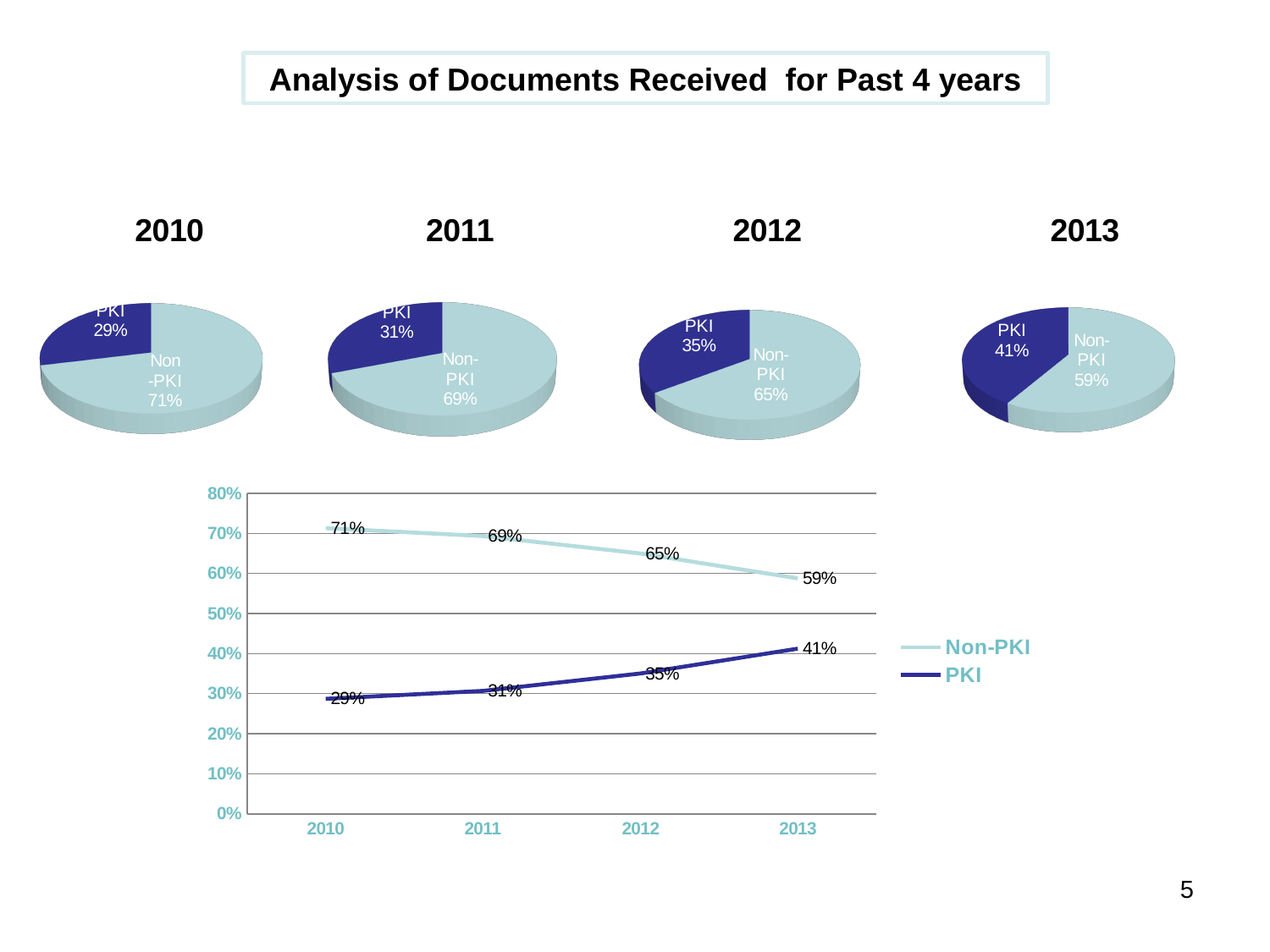
What type of chart is the chart at the bottom of the slide? line chart In the line chart at the bottom, what is the difference between the Non-PKI and PKI values in 2012? 30% In the line chart at the bottom, in which year is the Non-PKI value lowest? 2013 In the line chart at the bottom, what is the PKI value for 2013? 41% In the line chart at the bottom, in which year is the PKI value highest? 2013 In the line chart at the bottom, how many series does the legend list? 2 In the 2012 pie chart, what share of documents is PKI? 35% How many pie charts are shown on the slide? 4 In the 2010 pie chart, what share of documents is PKI? 29% In the line chart at the bottom, does the PKI line rise or fall from 2010 to 2013? rise In the 2013 pie chart, what share of documents is Non-PKI? 59% In the line chart at the bottom, what is the Non-PKI value for 2011? 69%